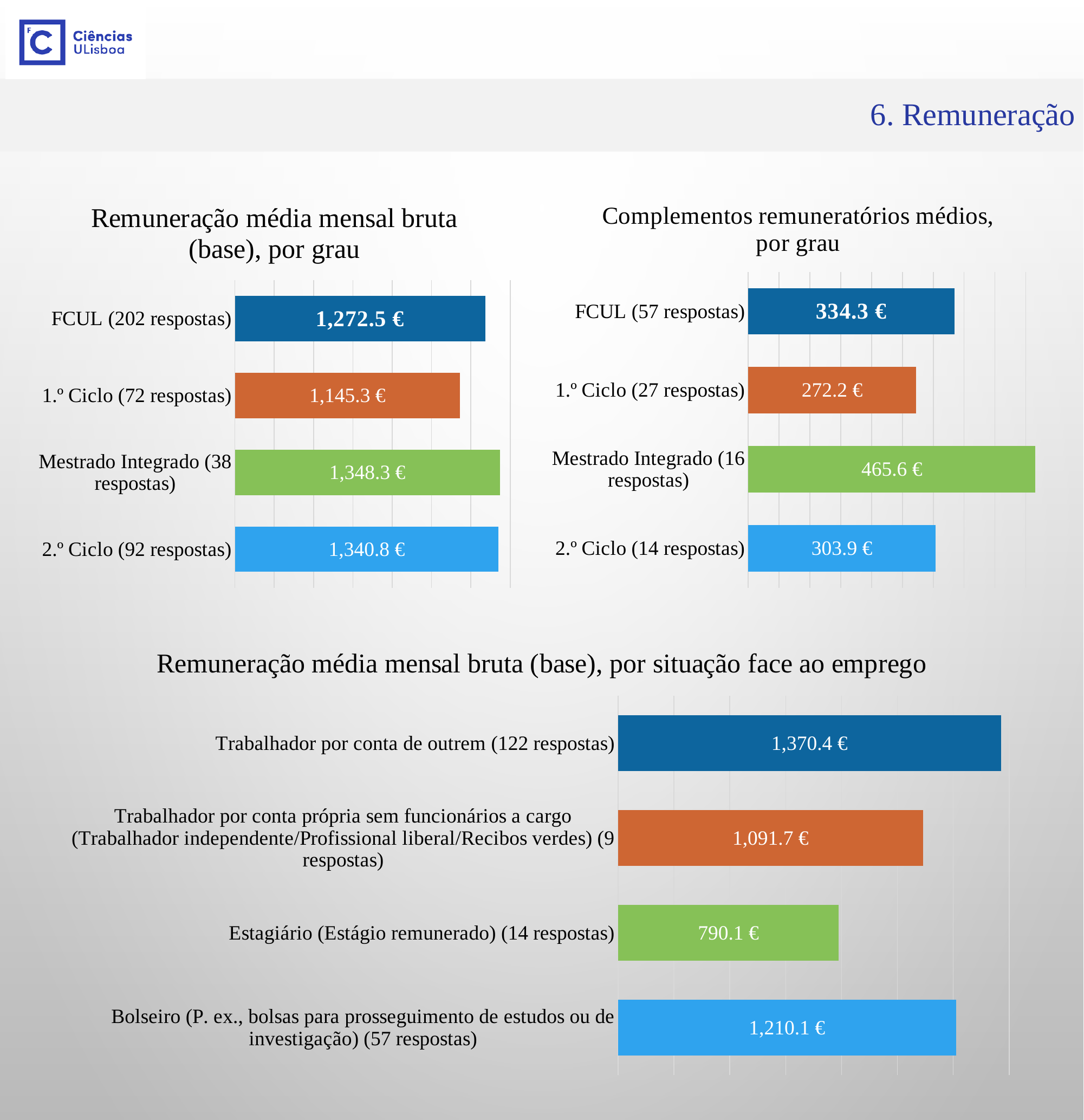
In the chart 'Remuneração média mensal bruta (base), por situação face ao emprego', which category has the highest value? Trabalhador por conta de outrem (122 respostas) What type of chart is 'Remuneração média mensal bruta (base), por situação face ao emprego'? Bar chart In the chart 'Remuneração média mensal bruta (base), por situação face ao emprego', which is larger: Bolseiro or Trabalhador por conta própria sem funcionários a cargo? Bolseiro In the chart 'Complementos remuneratórios médios, por grau', which category has the highest value? Mestrado Integrado (16 respostas) In the chart 'Complementos remuneratórios médios, por grau', how many categories are shown? 4 In the chart 'Complementos remuneratórios médios, por grau', what is the value for 2.º Ciclo (14 respostas)? 303.9 € In the chart 'Remuneração média mensal bruta (base), por grau', what is the value for FCUL (202 respostas)? 1,272.5 € In the chart 'Remuneração média mensal bruta (base), por situação face ao emprego', what is the value for Estagiário (Estágio remunerado) (14 respostas)? 790.1 € In the chart 'Complementos remuneratórios médios, por grau', what is the difference between Mestrado Integrado and 1.º Ciclo? 193.4 € In the chart 'Remuneração média mensal bruta (base), por grau', which category has the lowest value? 1.º Ciclo (72 respostas) In the chart 'Remuneração média mensal bruta (base), por situação face ao emprego', what is the difference between Trabalhador por conta de outrem and Estagiário? 580.3 € In the chart 'Remuneração média mensal bruta (base), por grau', what is the difference between Mestrado Integrado and 1.º Ciclo? 203.0 €